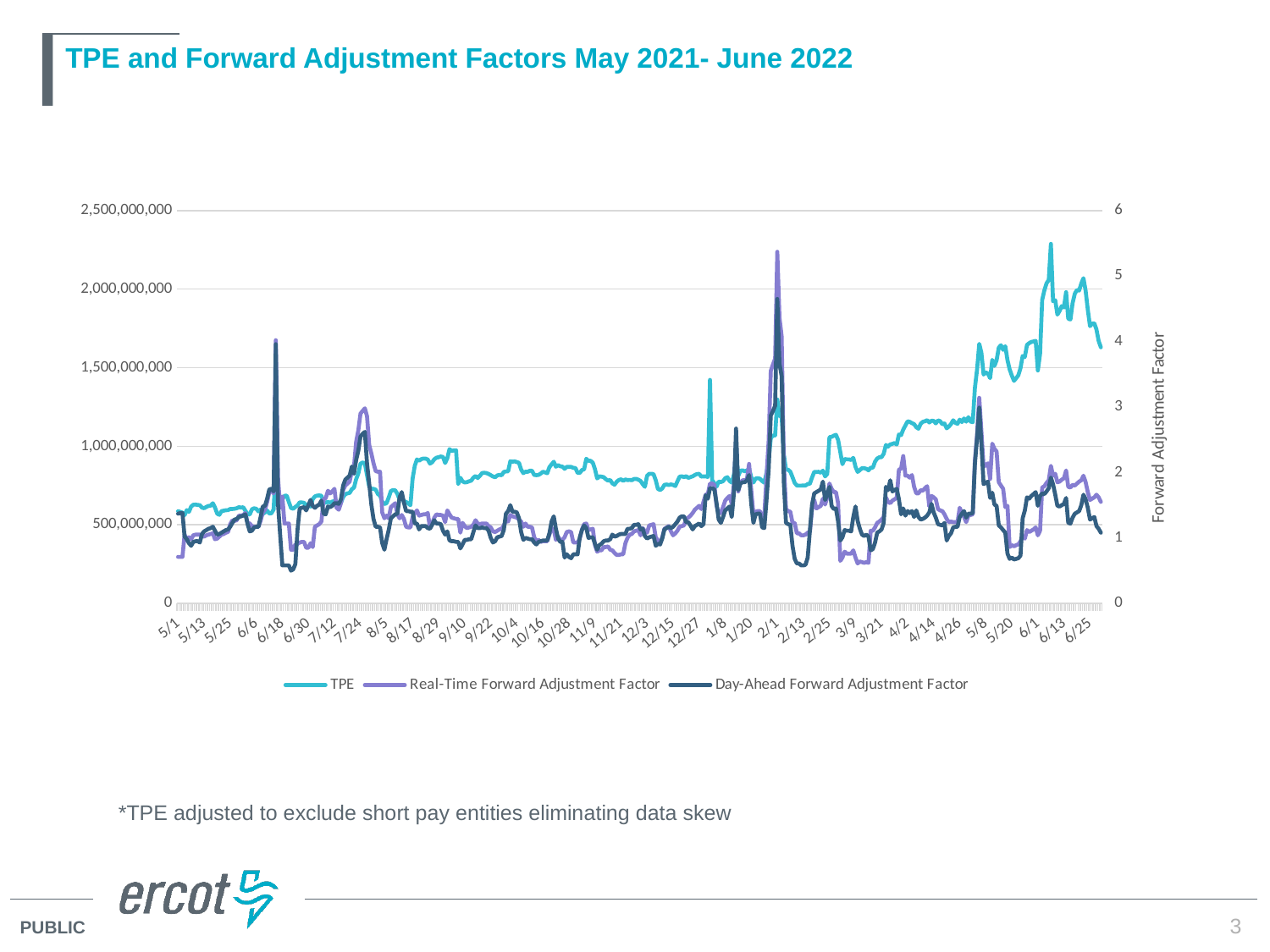
Is the TPE value at 6/25 greater or less than 1,500,000,000? greater How many series does the legend list? 3 In which month does the TPE series reach its highest value? June 2022 Which series reaches the highest value on the Forward Adjustment Factor axis, Real-Time or Day-Ahead? Real-Time Forward Adjustment Factor Is the Day-Ahead Forward Adjustment Factor spike near 6/18 greater or less than 3? greater Is the peak value of the TPE series in June 2022 greater or less than 2,000,000,000? greater What is the label of the right-hand vertical axis? Forward Adjustment Factor Does the TPE series overall rise or fall from May 2021 to June 2022? rise What is the title of the chart? TPE and Forward Adjustment Factors May 2021- June 2022 What kind of chart is shown on the slide? line chart